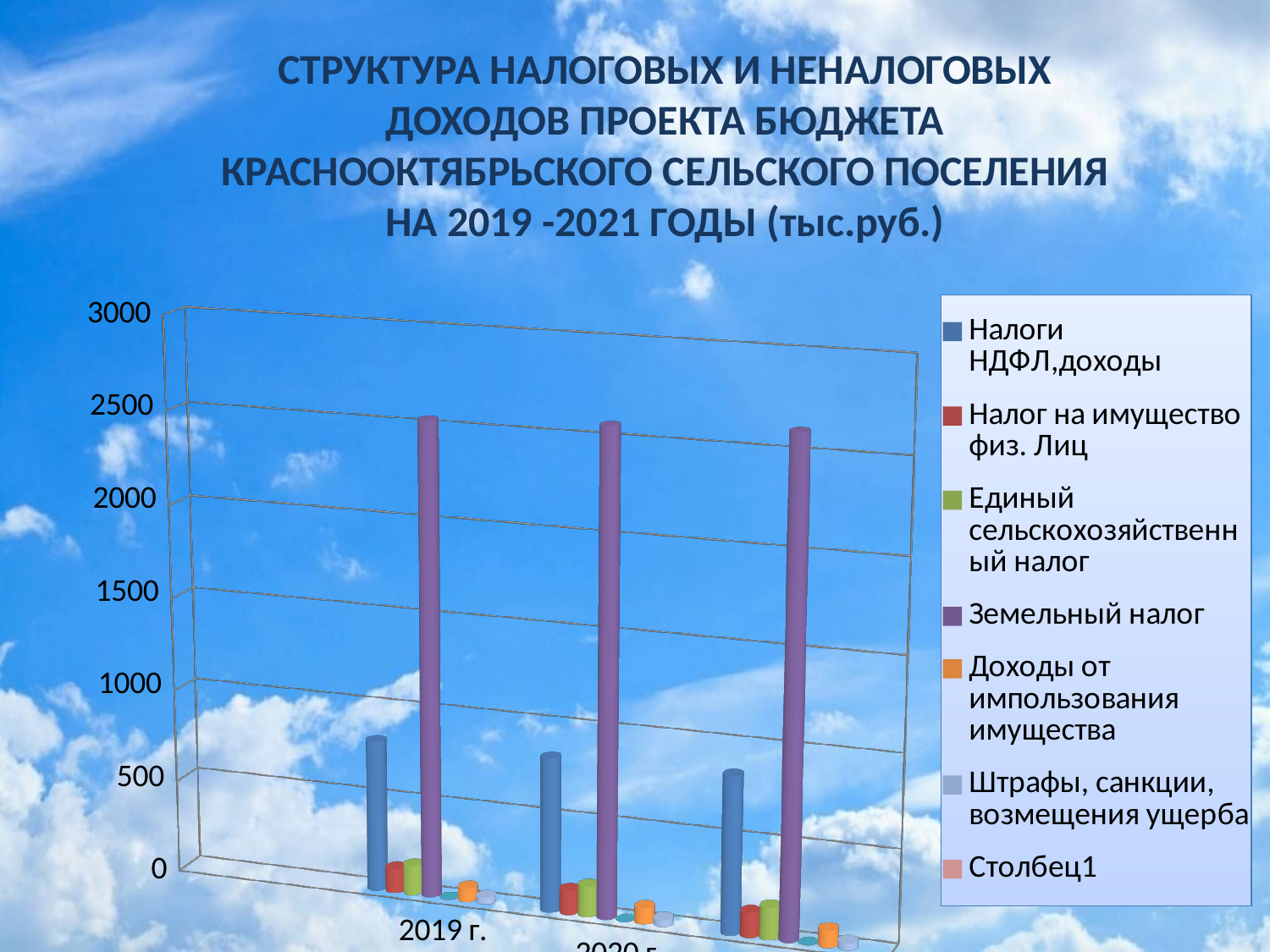
Is the value for Налоги НДФЛ,доходы in 2019 г. greater or less than 500? greater What colour represents Земельный налог in the legend? purple What is the highest value shown on the vertical axis? 3000 What kind of chart is shown on the slide? bar chart Is the value for Налог на имущество физ. Лиц in 2019 г. greater or less than 500? less Is the value for Земельный налог in 2019 г. greater or less than 2000? greater How many series does the legend list? 7 In 2019 г., which is larger: Земельный налог or Налоги НДФЛ,доходы? Земельный налог How many year groups of bars are plotted on the chart? 3 Which series has the highest value in 2019 г.? Земельный налог